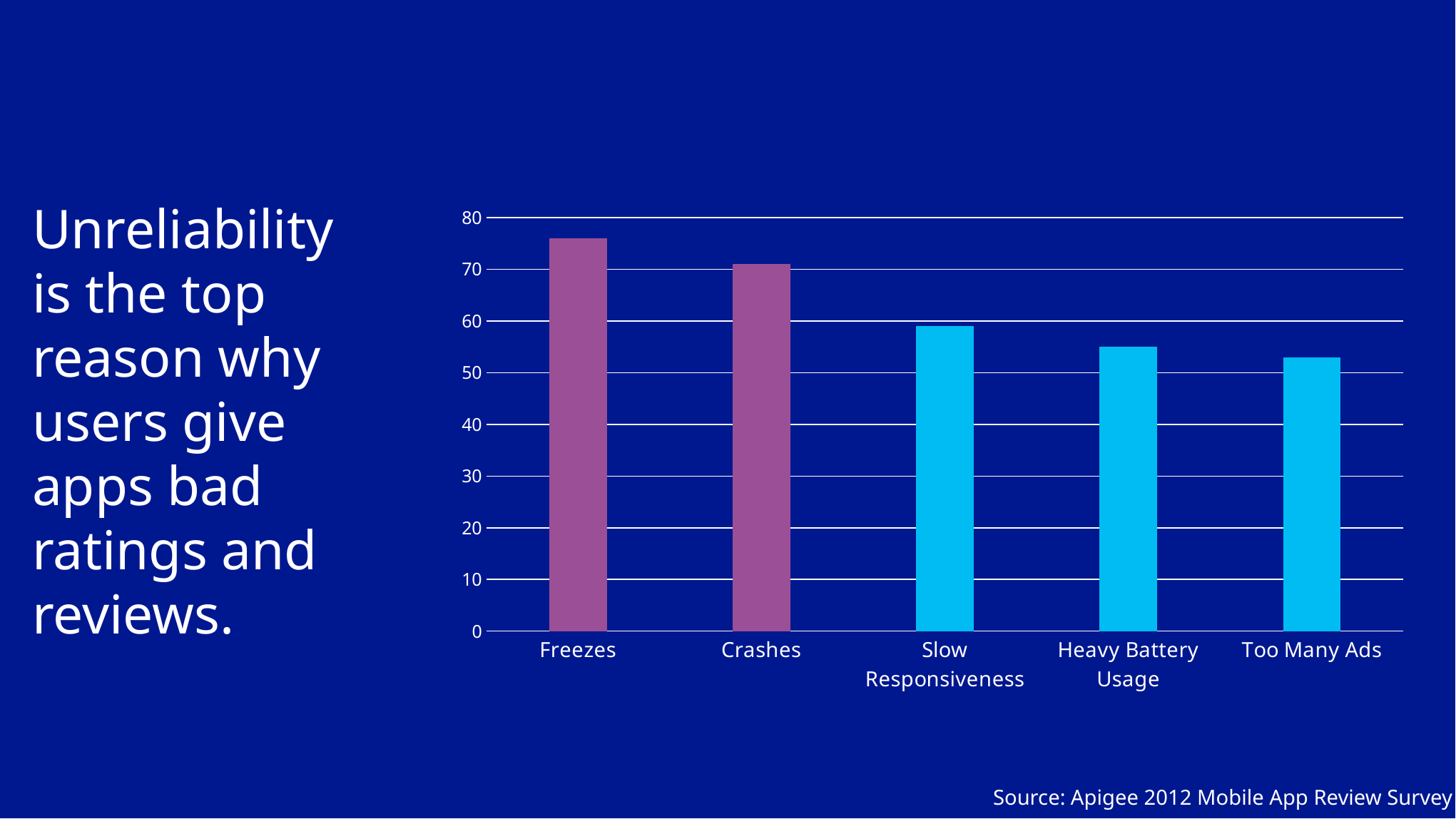
What colour are the bars for Freezes and Crashes? purple Which category has the highest bar in the chart? Freezes How many categories are shown on the x axis of the chart? 5 Which is larger, the value for Crashes or the value for Slow Responsiveness? Crashes Is the value for Heavy Battery Usage greater or less than 60? less Is the value for Too Many Ads greater or less than 50? greater Is the value for Freezes greater or less than 70? greater Which is larger, the value for Freezes or the value for Crashes? Freezes What kind of chart is shown on the slide? bar chart Do the bar values rise or fall from left to right across the categories? fall